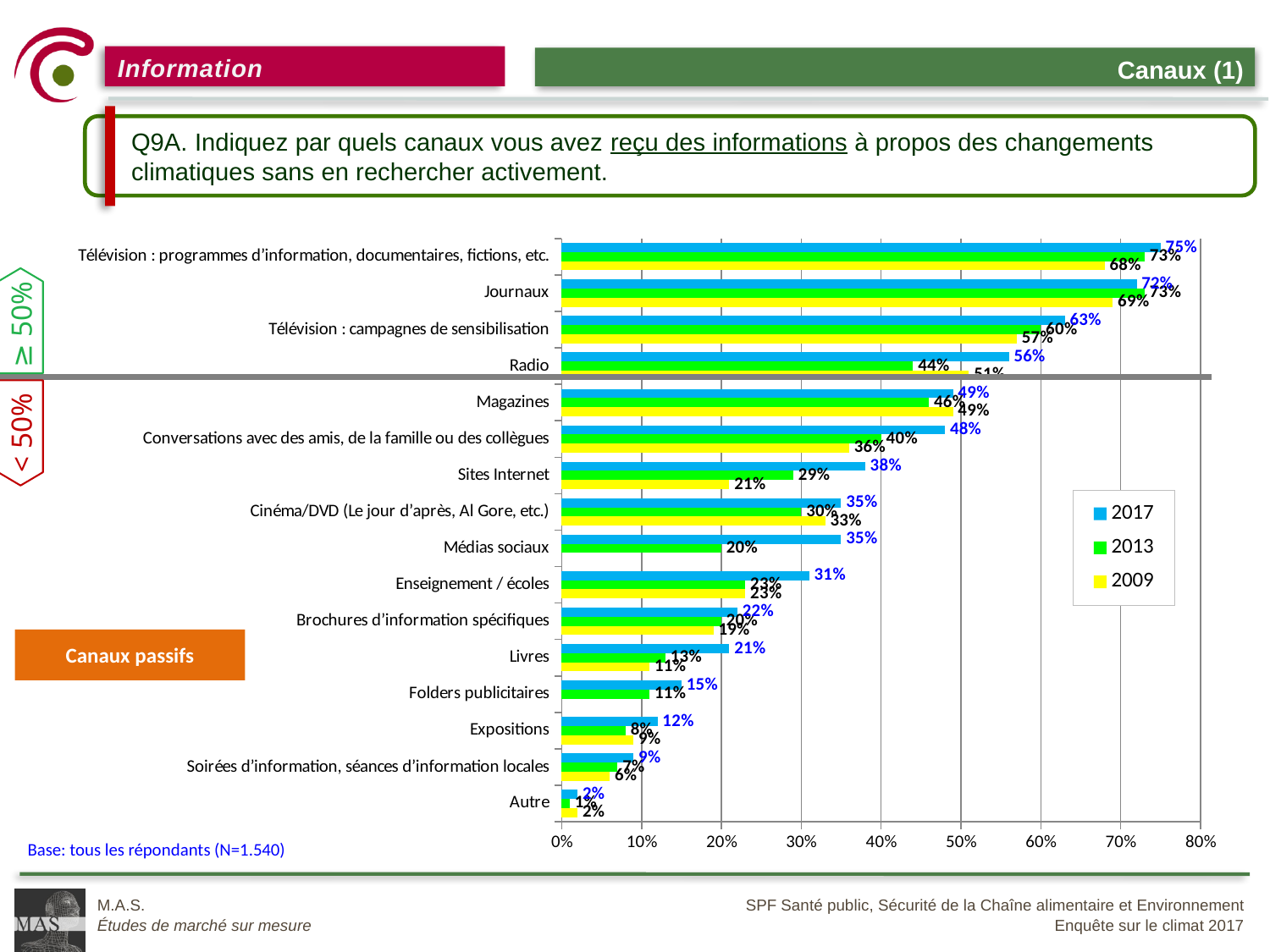
How many channels (categories) are shown in the chart? 16 For Radio, which year has the larger value, 2017 or 2009? 2017 What is the 2013 value for Sites Internet? 29% What is the difference between the 2017 and 2013 values for Médias sociaux? 15 percentage points Which channel has the lowest 2017 value? Autre What is the 2009 value for Télévision : programmes d'information, documentaires, fictions, etc.? 68% What is the 2017 value for Médias sociaux? 35% How many series does the legend list? 3 What are the entries in the chart legend? 2017, 2013, 2009 Which channel has the highest 2017 value? Télévision : programmes d'information, documentaires, fictions, etc. What kind of chart is shown on the slide? Bar chart What is the difference between the 2017 and 2009 values for Sites Internet? 17 percentage points